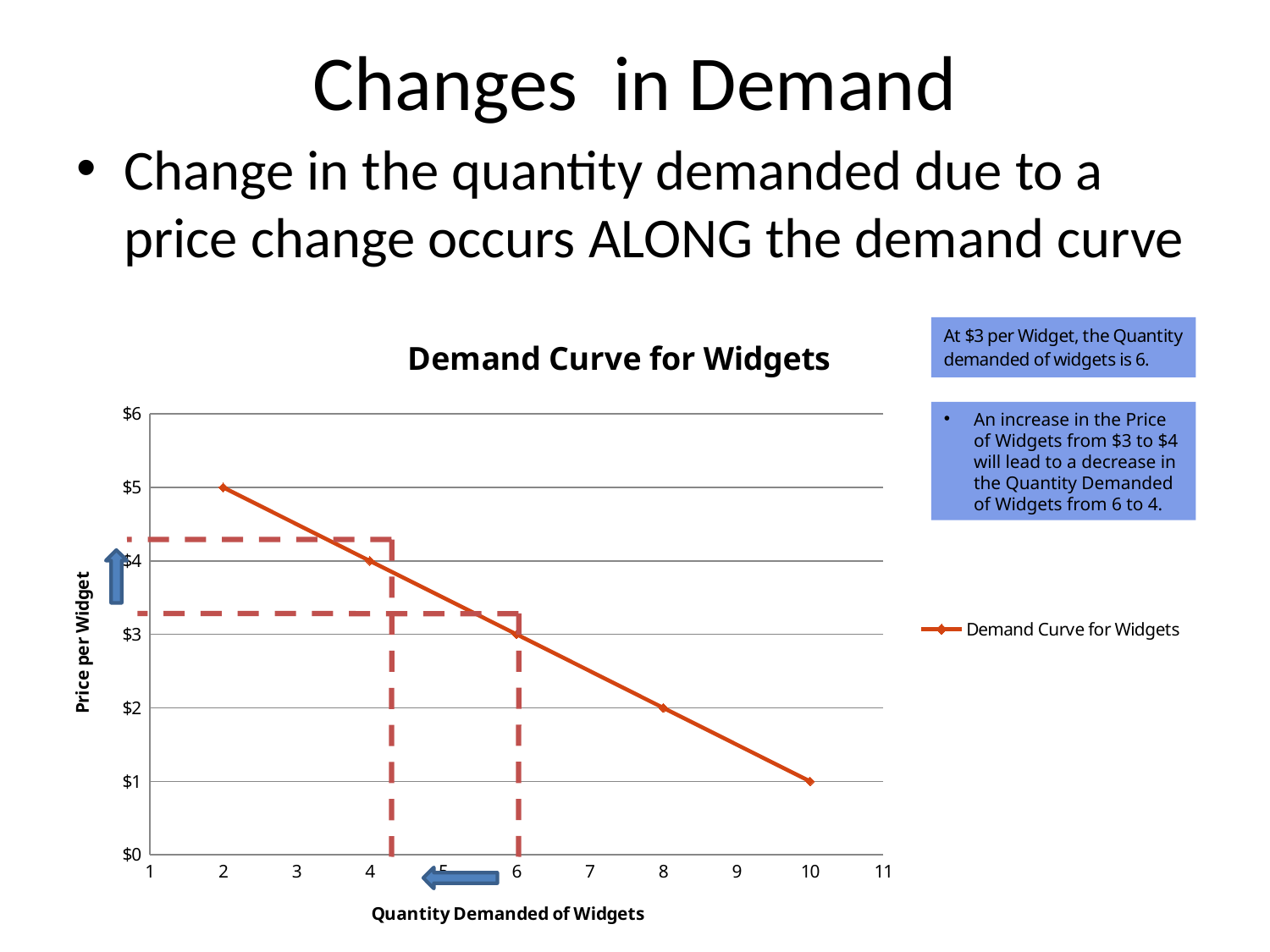
Which is higher: the price at a quantity demanded of 4 or the price at a quantity demanded of 8? quantity demanded of 4 What is the price per widget when the quantity demanded is 2? $5 Does the price per widget rise or fall as the quantity demanded increases along the x axis? fall What is the title of the chart? Demand Curve for Widgets How many series does the chart legend list? 1 What is the price per widget when the quantity demanded is 6? $3 How many data points are plotted on the demand curve? 5 What is the difference in price per widget between a quantity demanded of 4 and a quantity demanded of 8? $2 What is the price per widget when the quantity demanded is 10? $1 What kind of chart is shown on the slide? line chart Which quantity demanded corresponds to the highest price on the demand curve? 2 At what quantity demanded does the demand curve reach a price of $4? 4